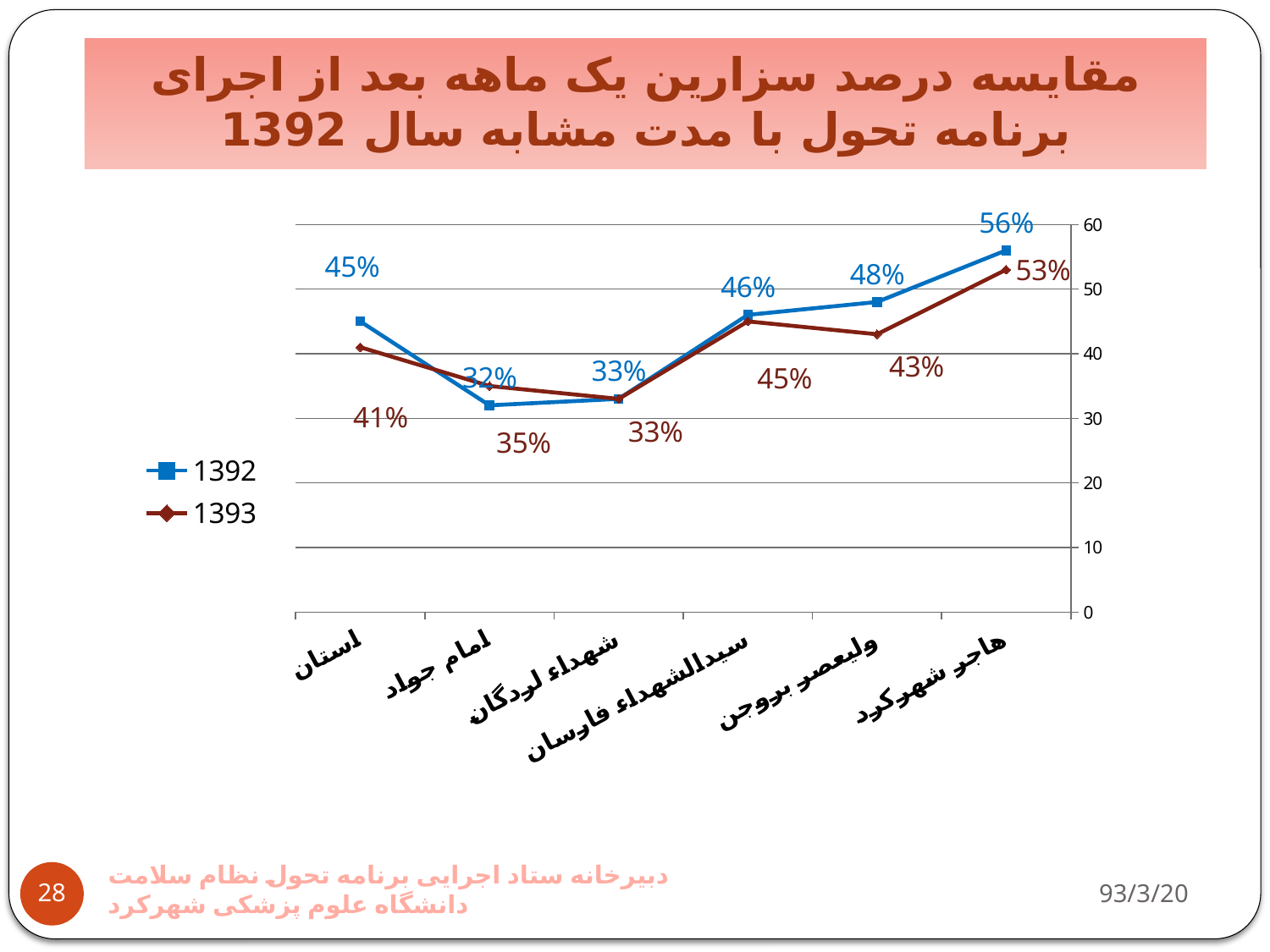
What is the difference between the 1392 and 1393 values for ولیعصر بروجن? 5% What is the value for استان in the 1393 series? 41% Do the values in the 1392 series rise or fall from سیدالشهداء فارسان to هاجر شهرکرد? rise What kind of chart is shown on the slide? line chart How many categories are shown on the x axis? 6 For امام جواد, which series has the larger value, 1392 or 1393? 1393 Which series is drawn in blue? 1392 Which category has the lowest value in the 1392 series? امام جواد Which category has the highest value in the 1392 series? هاجر شهرکرد How many series does the legend list? 2 What is the value for ولیعصر بروجن in the 1393 series? 43% What is the value for هاجر شهرکرد in the 1392 series? 56%